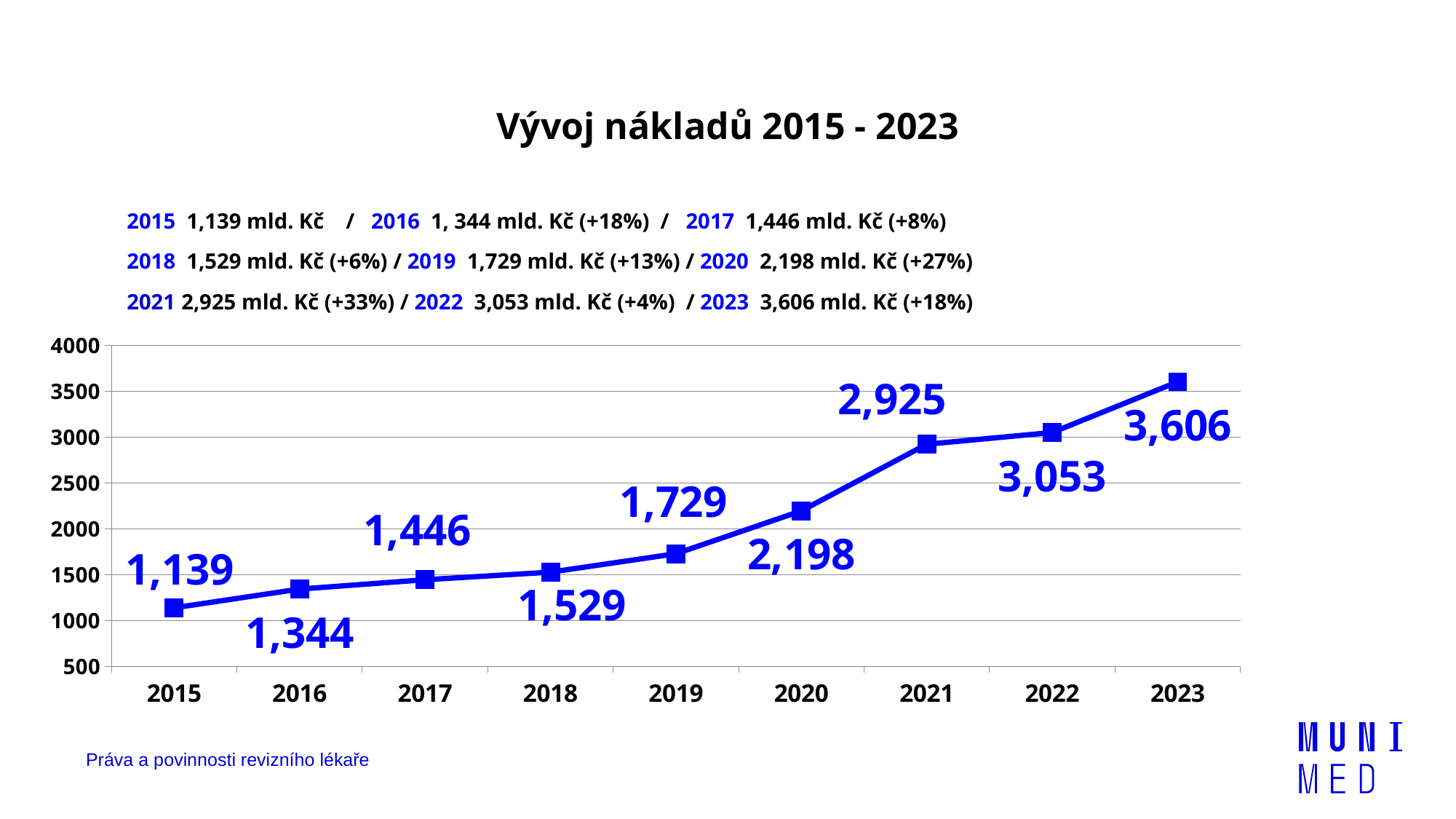
Which year has the lowest value on the chart? 2015 What is the difference between the values for 2023 and 2022? 553 What kind of chart is shown on the slide? line chart What is the value plotted for 2023? 3,606 Which year has the highest value on the chart? 2023 Do the values rise or fall from 2015 to 2023? rise What is the value plotted for 2019? 1,729 Which is larger, the value for 2018 or the value for 2020? 2020 What is the value plotted for 2015? 1,139 How many years are plotted on the chart? 9 Is the value for 2021 greater or less than 2500? greater What is the difference between the values for 2021 and 2020? 727